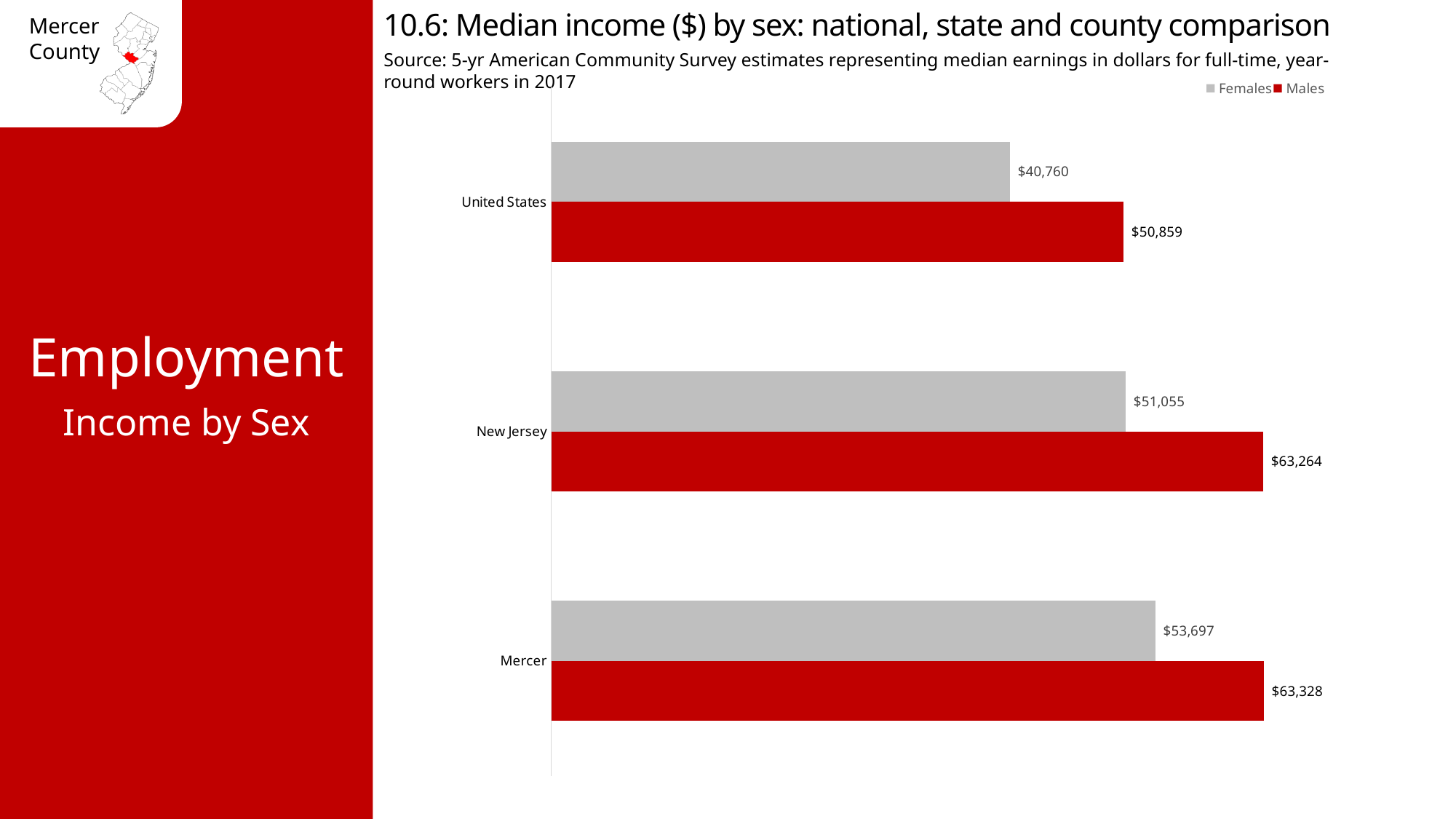
What is the difference between the Males and Females median income in Mercer? $9,631 Which is larger: the Females median income in Mercer or the Males median income in the United States? Females median income in Mercer What is the difference between the Males and Females median income in New Jersey? $12,209 What is the median income for Males in New Jersey? $63,264 Which geography has the lowest median income for Males? United States Which geography has the highest median income for Females? Mercer What is the median income for Males in the United States? $50,859 What is the median income for Females in the United States? $40,760 How many geographies are shown on the chart? 3 What is the median income for Females in Mercer? $53,697 How many series does the legend list? 2 What kind of chart is shown on the slide? Bar chart